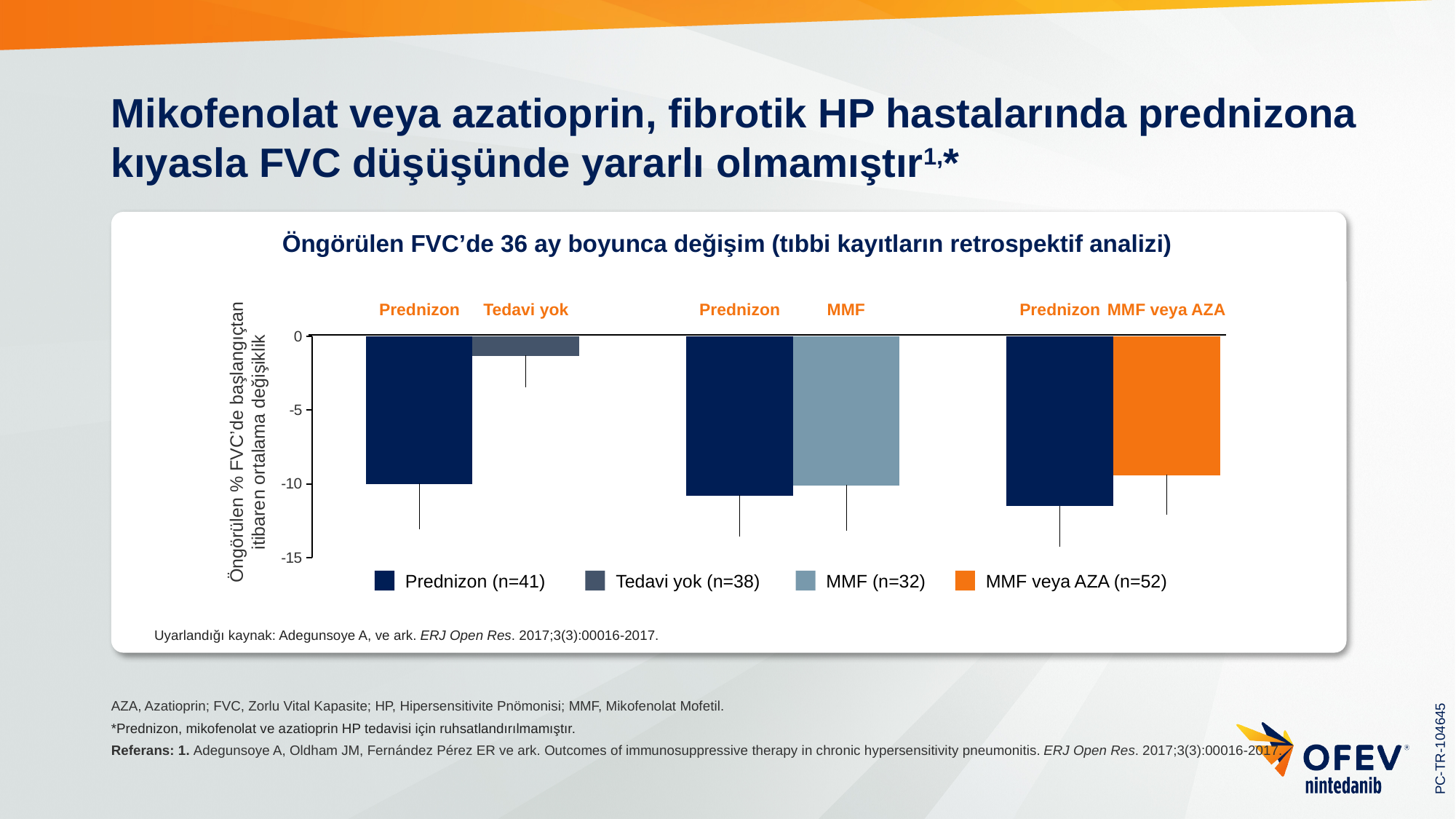
According to the legend, how many patients are in the MMF veya AZA group? n=52 How many series does the legend list? 4 Is the value for Tedavi yok greater or less than -5? greater In the third comparison, which has the larger decline in FVC, Prednizon or MMF veya AZA? Prednizon Is the value for the Prednizon bar next to MMF veya AZA greater or less than -10? less Is the value for MMF veya AZA greater or less than -10? greater Which bar shows the smallest decline in predicted FVC (value closest to 0)? Tedavi yok In the first comparison, which has the larger decline in FVC, Prednizon or Tedavi yok? Prednizon How many bars are plotted in the chart? 6 What kind of chart is shown on the slide? bar chart What is the lowest tick value shown on the y axis? -15